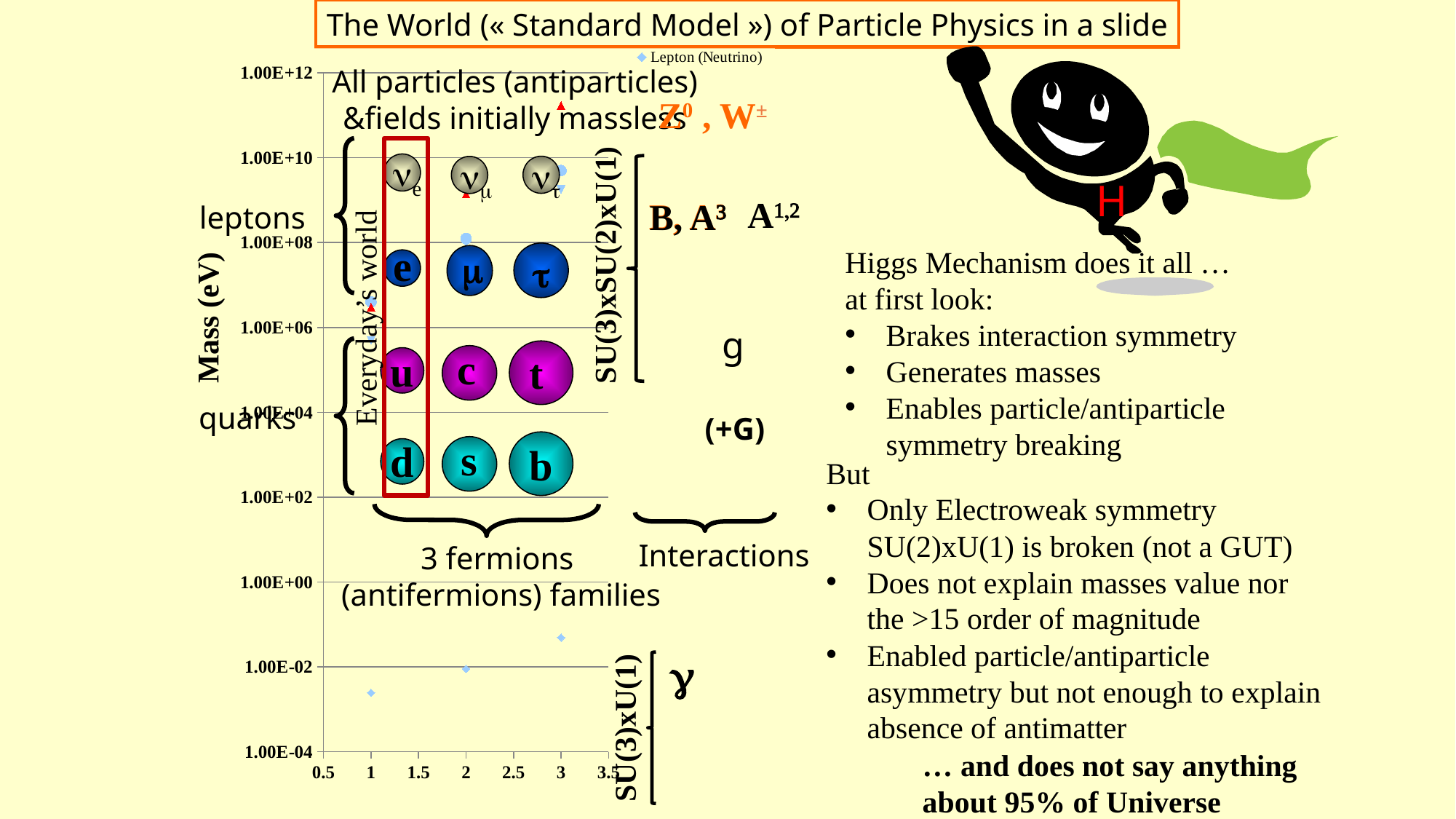
Is the Lepton (Neutrino) value at x = 3 greater or less than 1.00E-02? greater Which Lepton (Neutrino) point has the lowest mass on the chart? the point at x = 1 Which Lepton (Neutrino) point has the larger mass, the one at x = 1 or the one at x = 3? x = 3 What is the lowest tick value shown on the vertical axis? 1.00E-04 What series does the chart legend list? Lepton (Neutrino) Do the Lepton (Neutrino) values rise or fall as x increases from 1 to 3? rise How many Lepton (Neutrino) points are plotted on the chart? 3 Is the Lepton (Neutrino) value at x = 1 greater or less than 1.00E-02? less What is the highest tick value shown on the vertical axis? 1.00E+12 What kind of chart is shown on the slide? scatter chart What is the label of the vertical axis of the chart? Mass (eV)